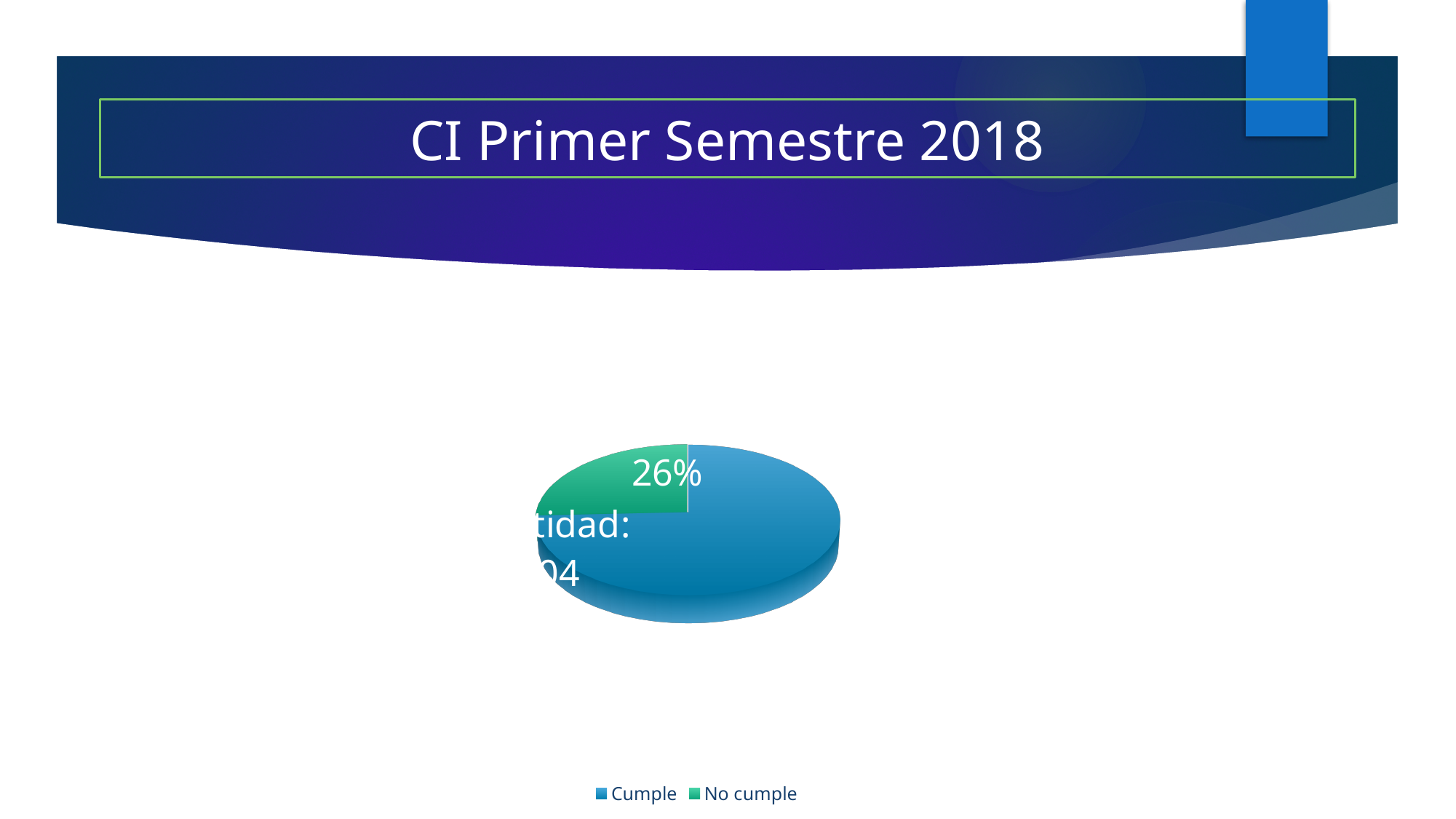
What is the title shown above the chart on the slide? CI Primer Semestre 2018 What colour is the "No cumple" slice in the pie chart? green Which slice is larger, "Cumple" or "No cumple"? Cumple How many slices does the pie chart have? 2 Which category has the largest slice of the pie? Cumple What kind of chart is shown on the slide? pie chart What share of the pie does the "No cumple" slice represent? 26% Is the share for "No cumple" greater or less than 50%? less Which category has the smallest slice of the pie? No cumple How many entries does the chart's legend list? 2